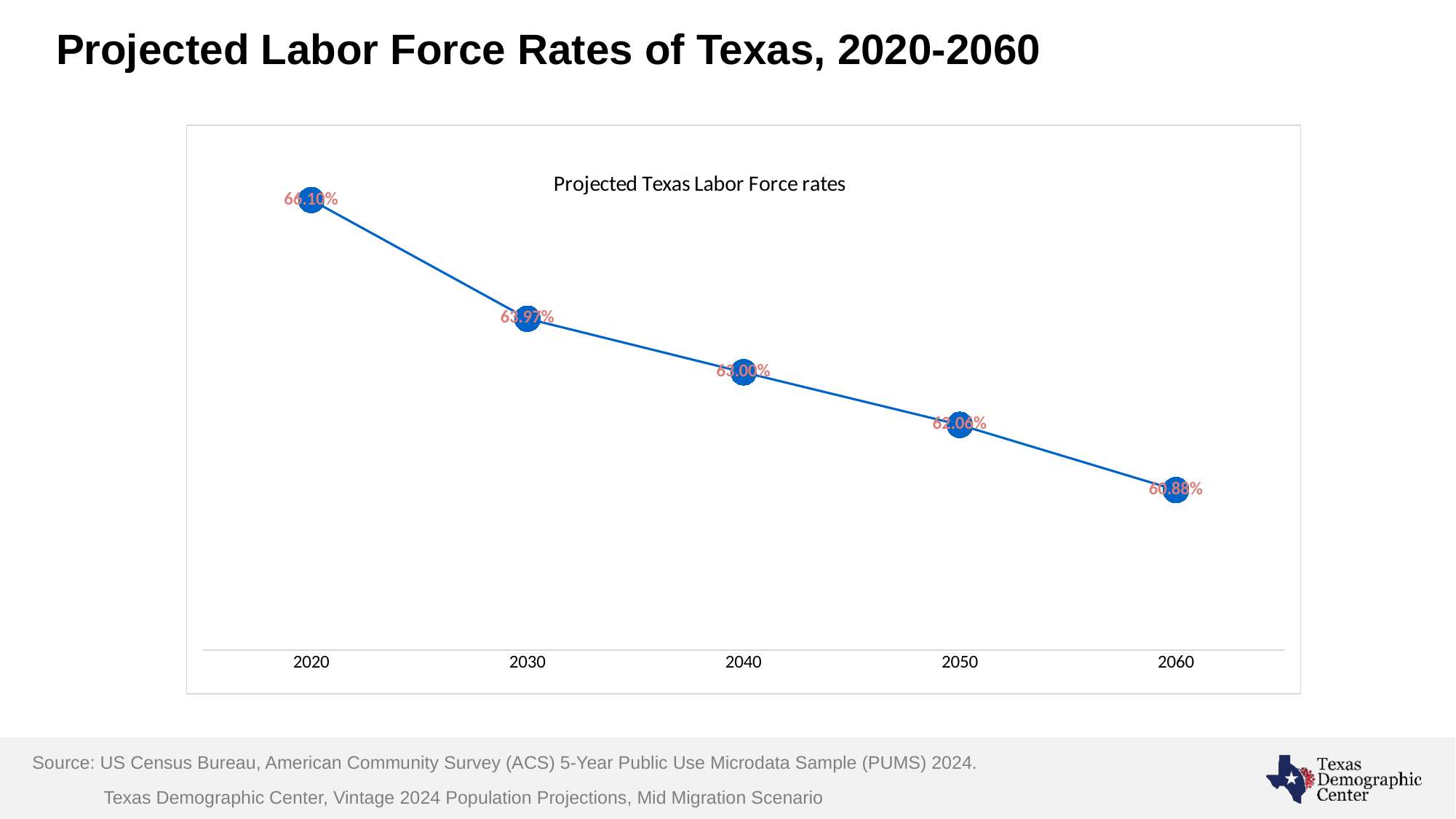
What is the projected labor force rate for 2040? 63.00% Which year has a higher projected labor force rate, 2030 or 2050? 2030 What is the projected labor force rate for 2060? 60.88% By how many percentage points does the projected labor force rate fall from 2020 to 2060? 5.22 percentage points What is the projected labor force rate for 2050? 62.06% Which year has the highest projected labor force rate? 2020 What is the projected labor force rate for 2030? 63.97% What is the projected labor force rate for 2020? 66.10% How many years are plotted on the chart? 5 What kind of chart is shown on the slide? Line chart Do the projected labor force rates rise or fall from 2020 to 2060? Fall Which year has the lowest projected labor force rate? 2060